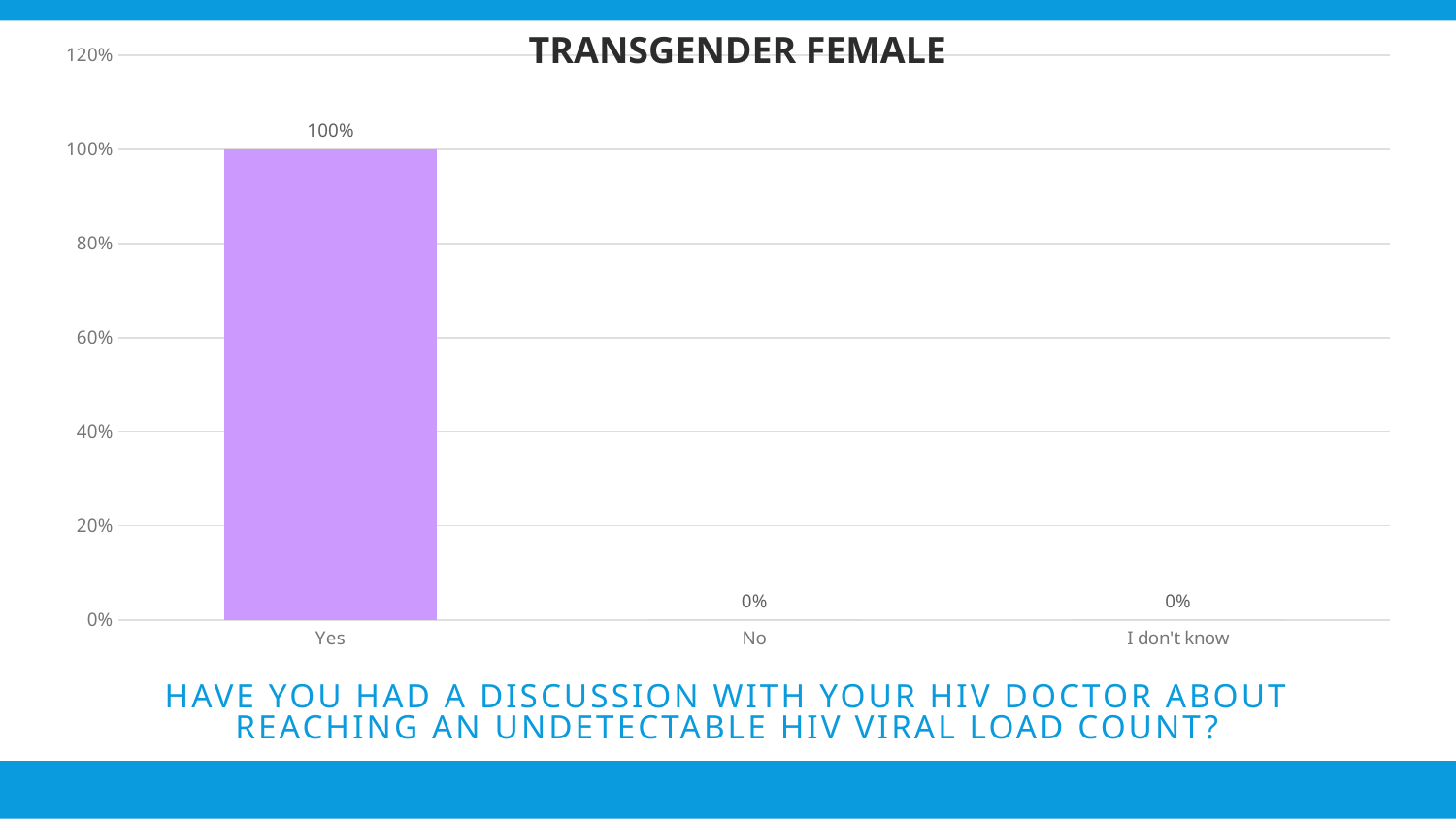
What colour is the bar for Yes? purple What is the value for No? 0% Which is larger, the value for Yes or the value for I don't know? Yes How many categories are shown on the x axis? 3 What is the highest value shown on the y axis? 120% What is the value for I don't know? 0% Is the value for Yes greater or less than 80%? greater What is the difference between the values for Yes and No? 100% What kind of chart is shown on the slide? bar chart Which category has the highest value? Yes What is the title of the chart? TRANSGENDER FEMALE What is the value for Yes? 100%